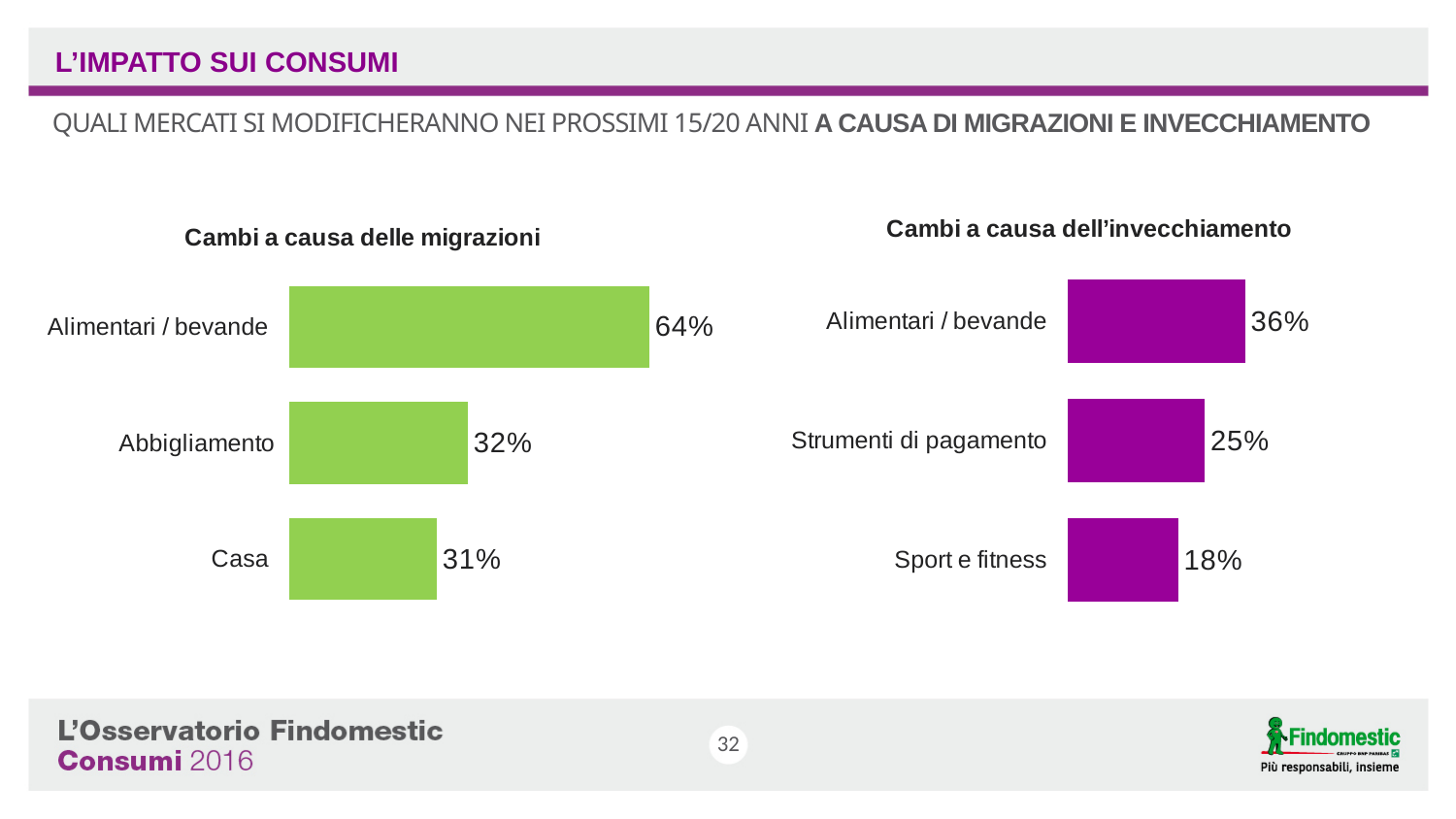
In the 'Cambi a causa delle migrazioni' chart, what is the difference between Alimentari / bevande and Abbigliamento? 32% In the 'Cambi a causa dell'invecchiamento' chart, what is the value for Sport e fitness? 18% In the 'Cambi a causa dell'invecchiamento' chart, what is the difference between Alimentari / bevande and Sport e fitness? 18% In the 'Cambi a causa delle migrazioni' chart, what is the value for Casa? 31% How many categories are shown in the 'Cambi a causa dell'invecchiamento' chart? 3 Which is larger: Alimentari / bevande in the 'Cambi a causa delle migrazioni' chart or Alimentari / bevande in the 'Cambi a causa dell'invecchiamento' chart? Cambi a causa delle migrazioni What colour are the bars in the 'Cambi a causa dell'invecchiamento' chart? Purple In the 'Cambi a causa delle migrazioni' chart, which category has the highest value? Alimentari / bevande In the 'Cambi a causa dell'invecchiamento' chart, what is the value for Strumenti di pagamento? 25% In the 'Cambi a causa dell'invecchiamento' chart, which category has the lowest value? Sport e fitness What type of chart is the 'Cambi a causa delle migrazioni' chart? Bar chart In the 'Cambi a causa delle migrazioni' chart, what is the value for Alimentari / bevande? 64%